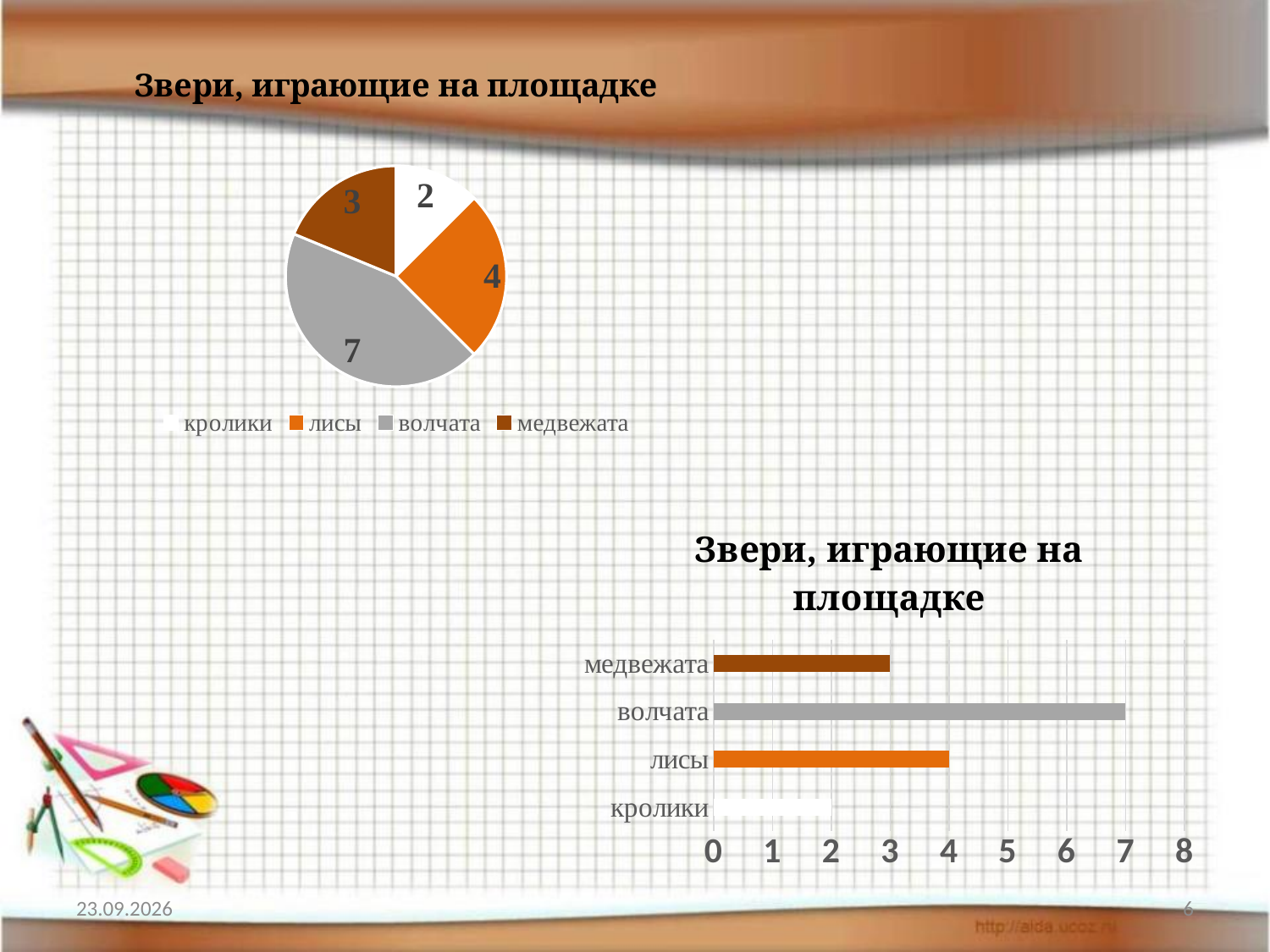
In the pie chart at the top left, what share of the total do волчата make up? 43.75% In the pie chart at the top left, what is the value for кролики? 2 In the bar chart 'Звери, играющие на площадке', which is larger, the value for лисы or the value for медвежата? лисы In the pie chart at the top left, what is the value for волчата? 7 In the bar chart 'Звери, играющие на площадке', what is the value for лисы? 4 In the pie chart at the top left, what is the difference between the values for лисы and медвежата? 1 What kind of chart is the chart titled 'Звери, играющие на площадке' at the bottom right? bar chart In the pie chart at the top left, which category has the largest slice? волчата In the bar chart 'Звери, играющие на площадке', is the value for медвежата greater or less than 5? less In the bar chart 'Звери, играющие на площадке', which category has the longest bar? волчата In the pie chart at the top left, how many categories does the legend list? 4 In the pie chart at the top left, which category has the smallest slice? кролики